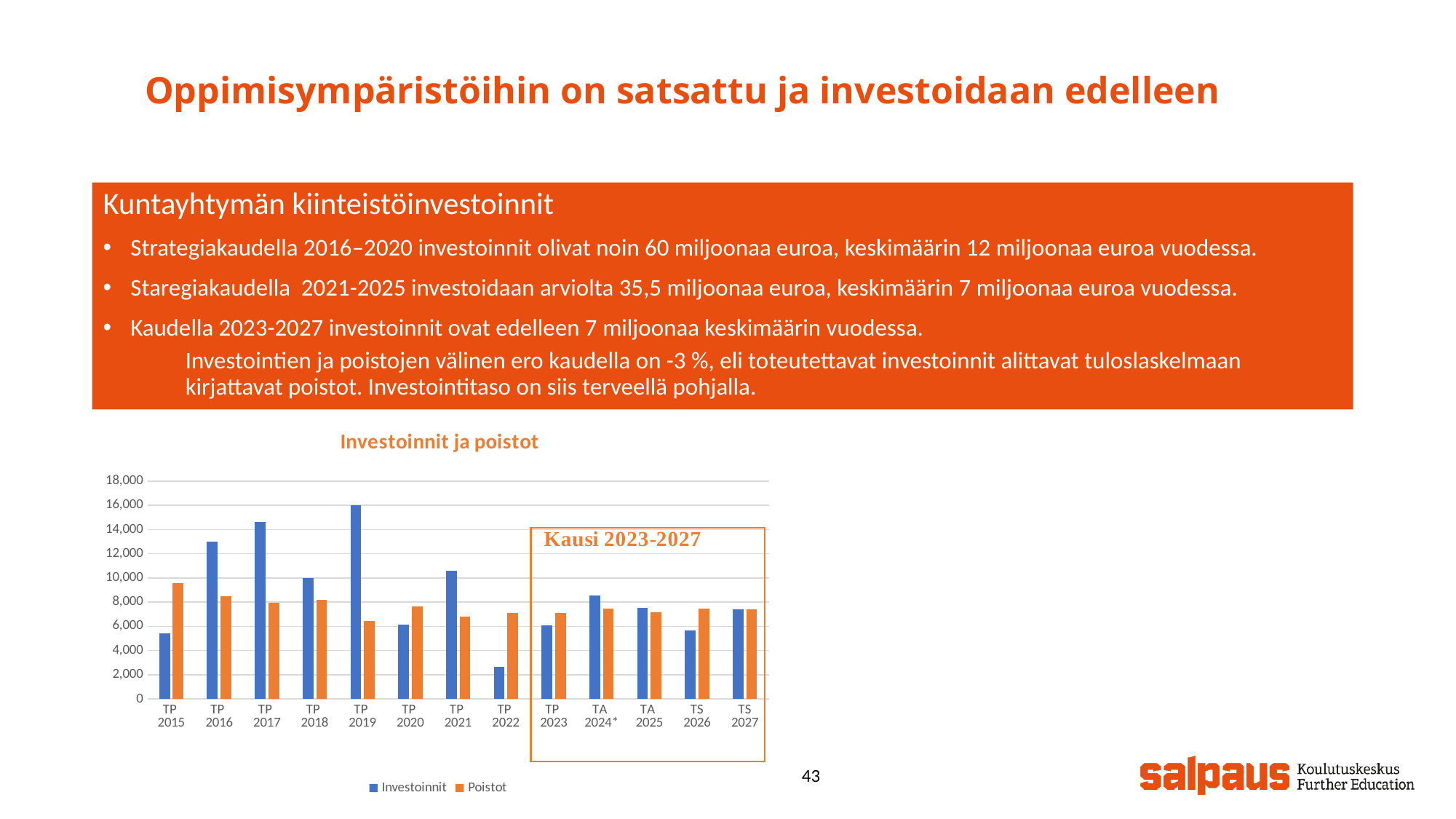
Which colour represents the Poistot series in the chart? orange How many categories are shown on the x axis of the chart? 13 How many series does the chart legend list? 2 Which category has the highest Investoinnit value? TP 2019 Is the Poistot value for TP 2015 greater or less than 8,000? greater Which category has the highest Poistot value? TP 2015 What is the title of the chart? Investoinnit ja poistot Is the Investoinnit value for TP 2019 greater or less than 14,000? greater For TP 2016, which is larger: Investoinnit or Poistot? Investoinnit What kind of chart is shown on the slide? bar chart Which category has the lowest Investoinnit value? TP 2022 Is the Investoinnit value for TP 2022 greater or less than 4,000? less